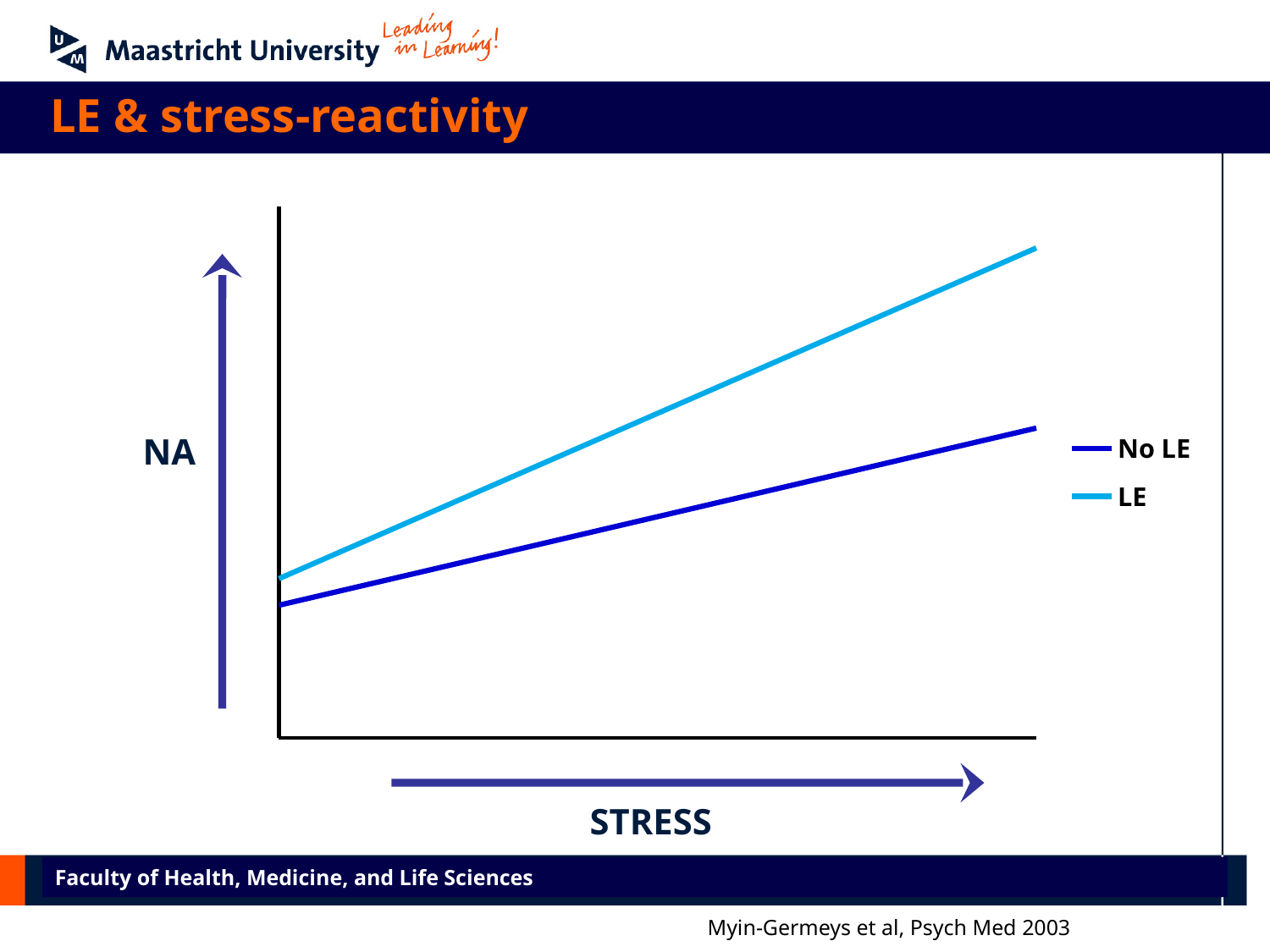
Which series is drawn in light blue? LE What kind of chart is shown on the slide? line chart What is the label on the vertical axis? NA Does the LE line rise or fall as STRESS increases? rise What is the label on the horizontal axis? STRESS Does the No LE line rise or fall as STRESS increases? rise Which series has the steeper slope, LE or No LE? LE At the right end of the x axis, which series has the higher NA value, LE or No LE? LE How many series does the legend list? 2